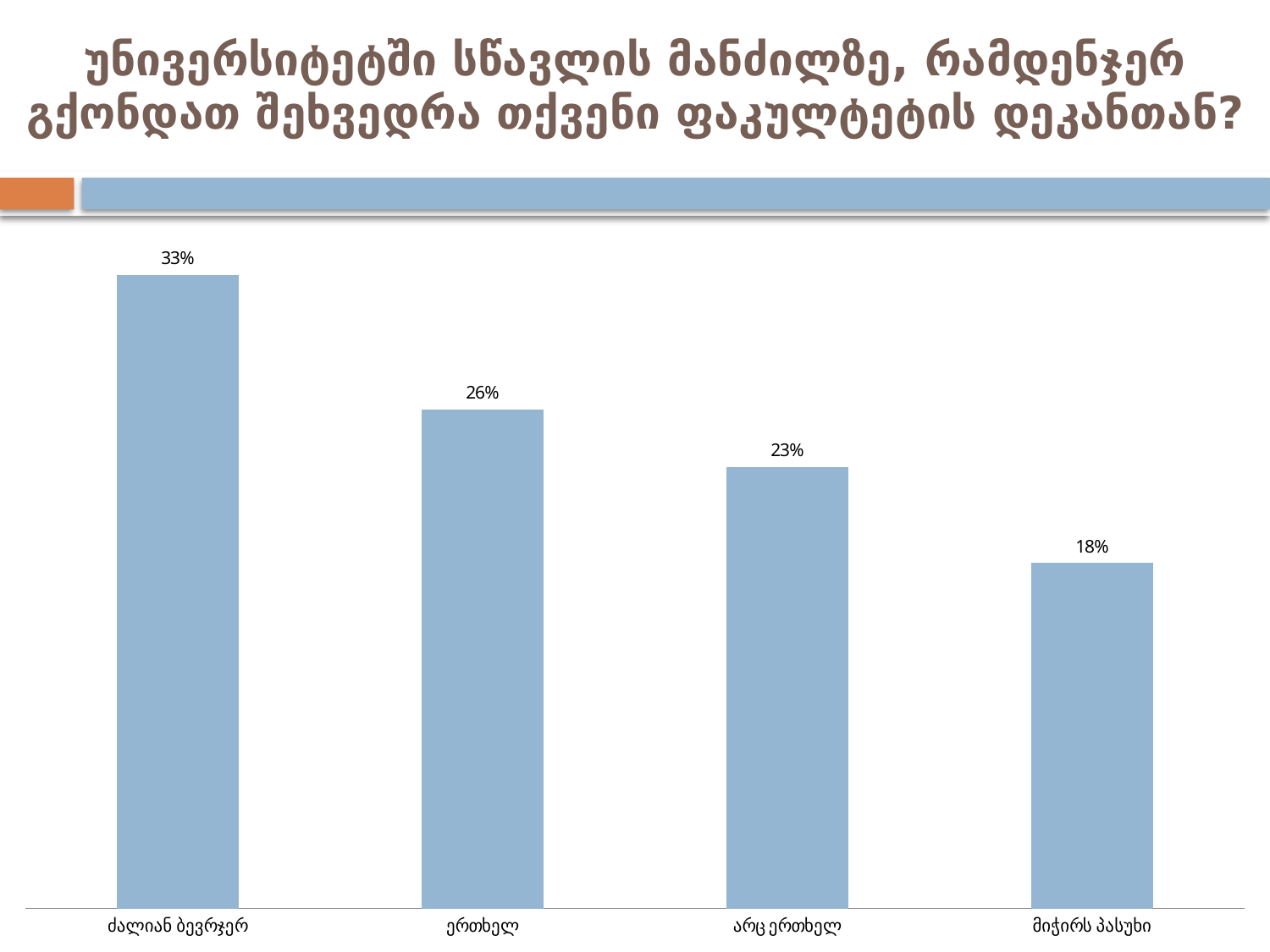
Which is larger, the value for ერთხელ or the value for მიჭირს პასუხი? ერთხელ What is the value for ერთხელ? 26% Do the values rise or fall from left to right across the categories? Fall What is the value for არც ერთხელ? 23% What kind of chart is shown on the slide? Bar chart What is the difference between the values for ძალიან ბევრჯერ and მიჭირს პასუხი? 15% What is the difference between the values for ერთხელ and არც ერთხელ? 3% Which category has the highest value? ძალიან ბევრჯერ How many categories are shown in the chart? 4 What is the value for ძალიან ბევრჯერ? 33% What is the value for მიჭირს პასუხი? 18% Which category has the lowest value? მიჭირს პასუხი